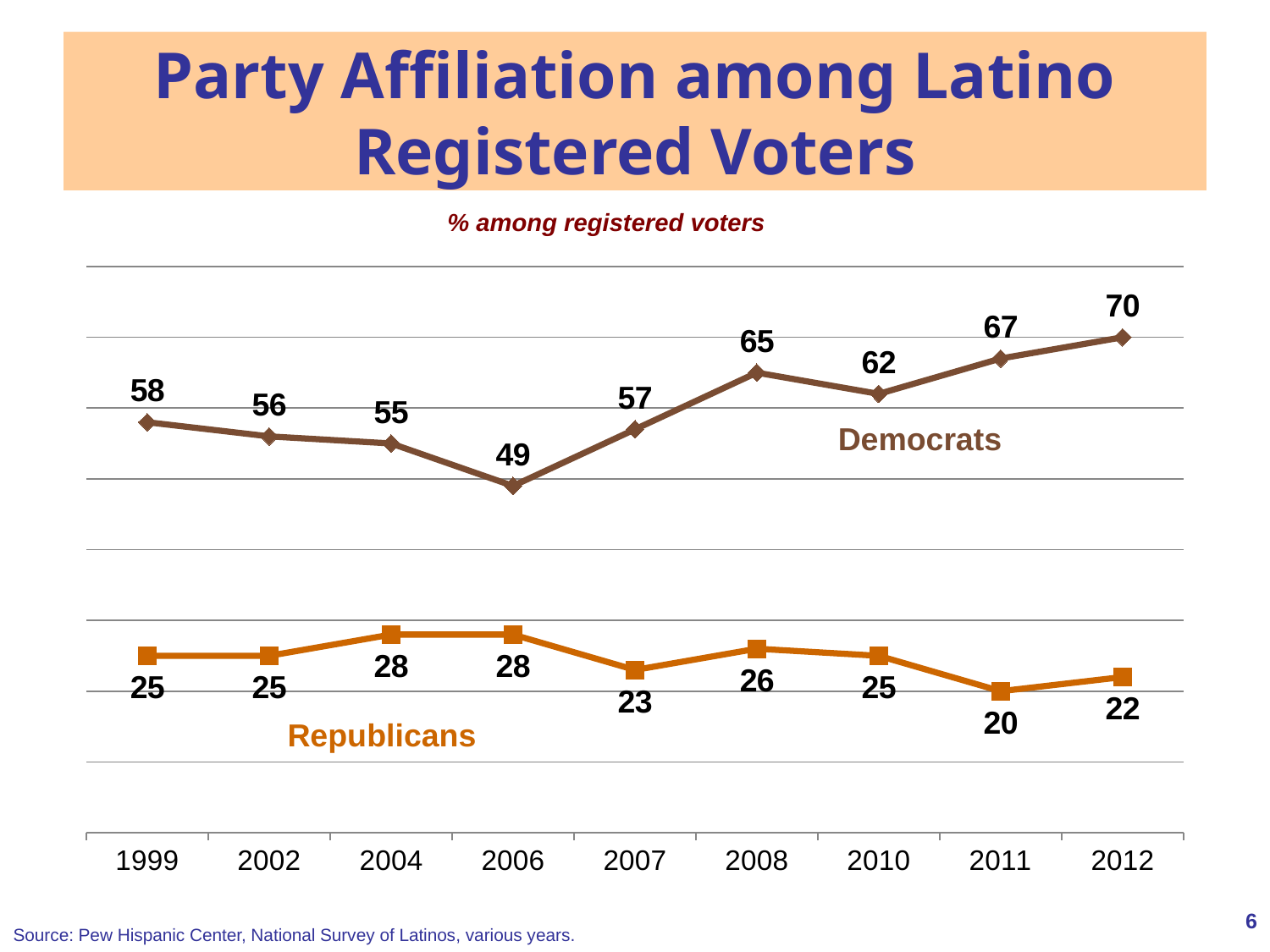
In which year is the Democrats line at its lowest? 2006 Does the Democrats line rise or fall from 2006 to 2012? Rise Which is larger, the Republicans value in 2004 or in 2007? 2004 In which year is the Democrats line at its highest? 2012 What is the difference between the Democrats and Republicans values in 2012? 48 What kind of chart is shown on the slide? Line chart In which year is the Republicans line at its lowest? 2011 How many years are shown on the x axis? 9 How many series are plotted on the chart? 2 What is the value for Republicans in 2011? 20 What is the value for Democrats in 2012? 70 What is the value for Democrats in 2006? 49